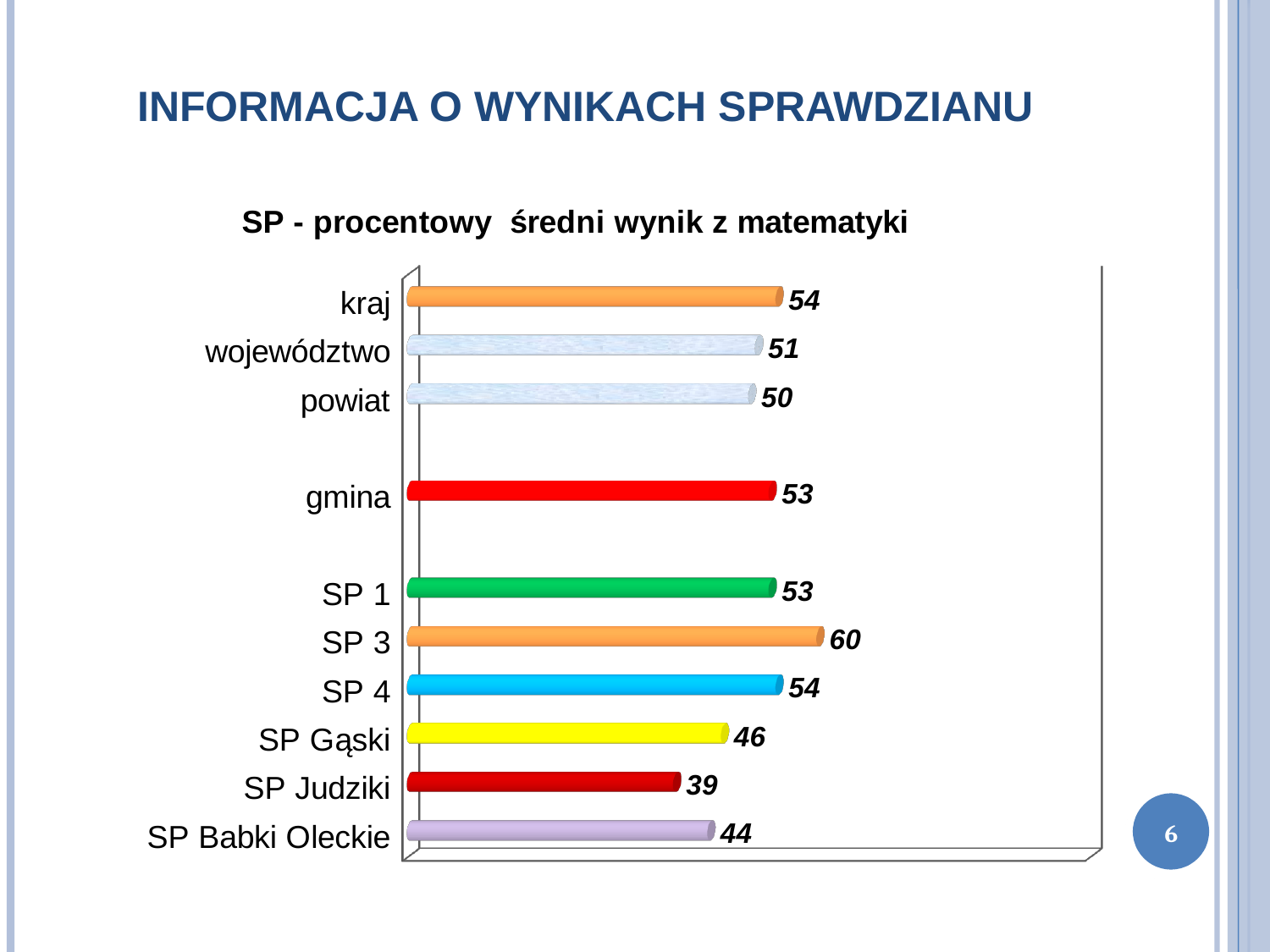
Which category has the highest value? SP 3 Which is larger, the value for SP Gąski or the value for SP Babki Oleckie? SP Gąski What is the value for SP Judziki? 39 What is the value for SP 3? 60 Which category has the lowest value? SP Judziki How many categories are shown in the chart? 10 What is the difference between the values for kraj and powiat? 4 What is the title of the chart? SP - procentowy średni wynik z matematyki What kind of chart is shown on the slide? bar chart What is the value for województwo? 51 What is the difference between the values for SP 3 and SP Judziki? 21 What is the value for gmina? 53